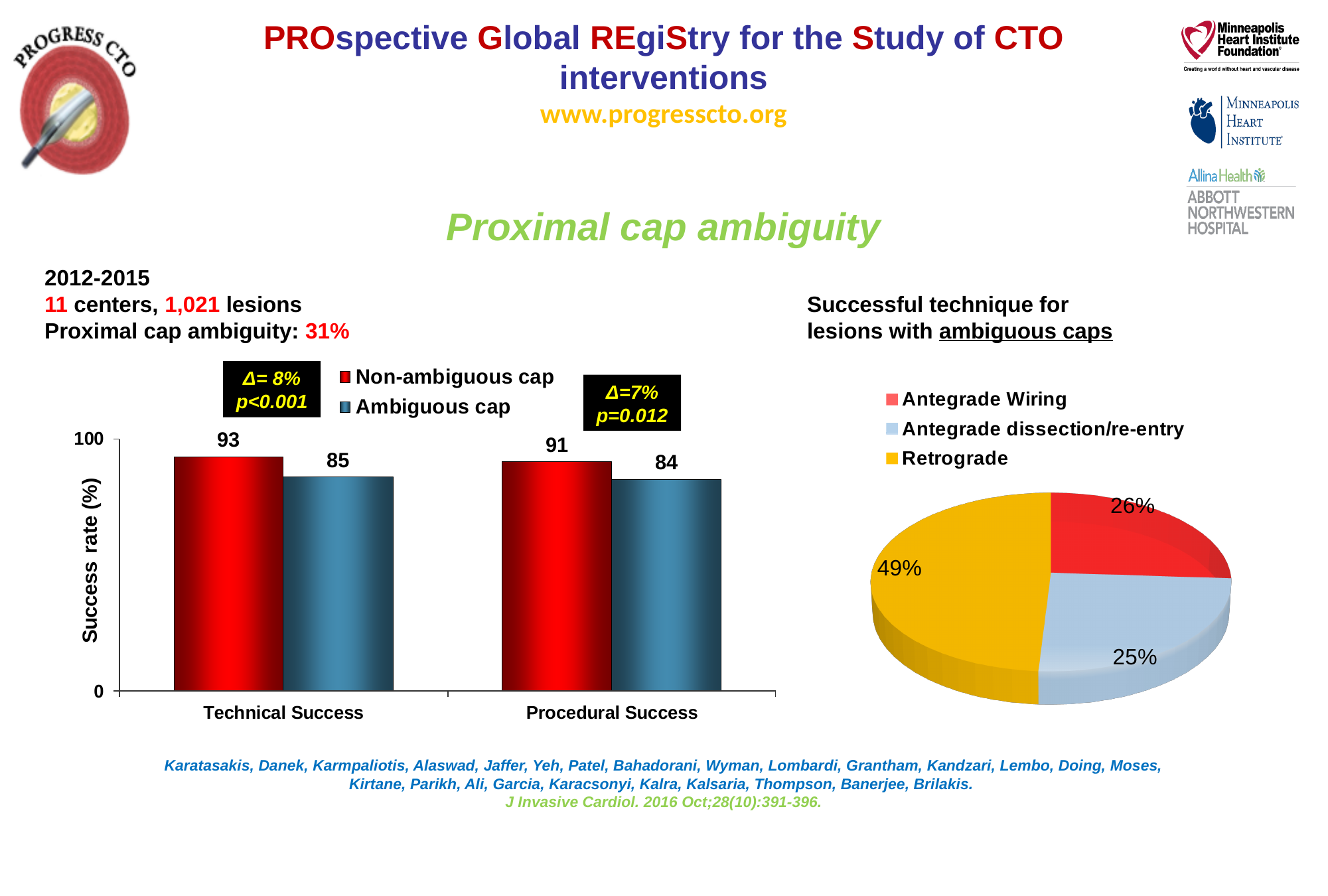
In the pie chart on the right, what share of successful techniques for lesions with ambiguous caps was Retrograde? 49% In the bar chart on the left, which has the higher procedural success rate: non-ambiguous cap or ambiguous cap? Non-ambiguous cap In the pie chart on the right, which technique has the largest share? Retrograde How many slices does the pie chart on the right have? 3 How many series does the legend of the bar chart on the left list? 2 In the bar chart on the left, what is the difference between the technical success rates of non-ambiguous and ambiguous caps? 8 In the bar chart on the left, what is the technical success rate for lesions with a non-ambiguous cap? 93 In the bar chart on the left, what is the procedural success rate for lesions with an ambiguous cap? 84 What type of chart is the chart on the left of the slide? Bar chart In the pie chart on the right, what share was Antegrade Wiring? 26% In the bar chart on the left, what is the label of the y axis? Success rate (%) In the bar chart on the left, which bar has the lowest value? Ambiguous cap, Procedural Success